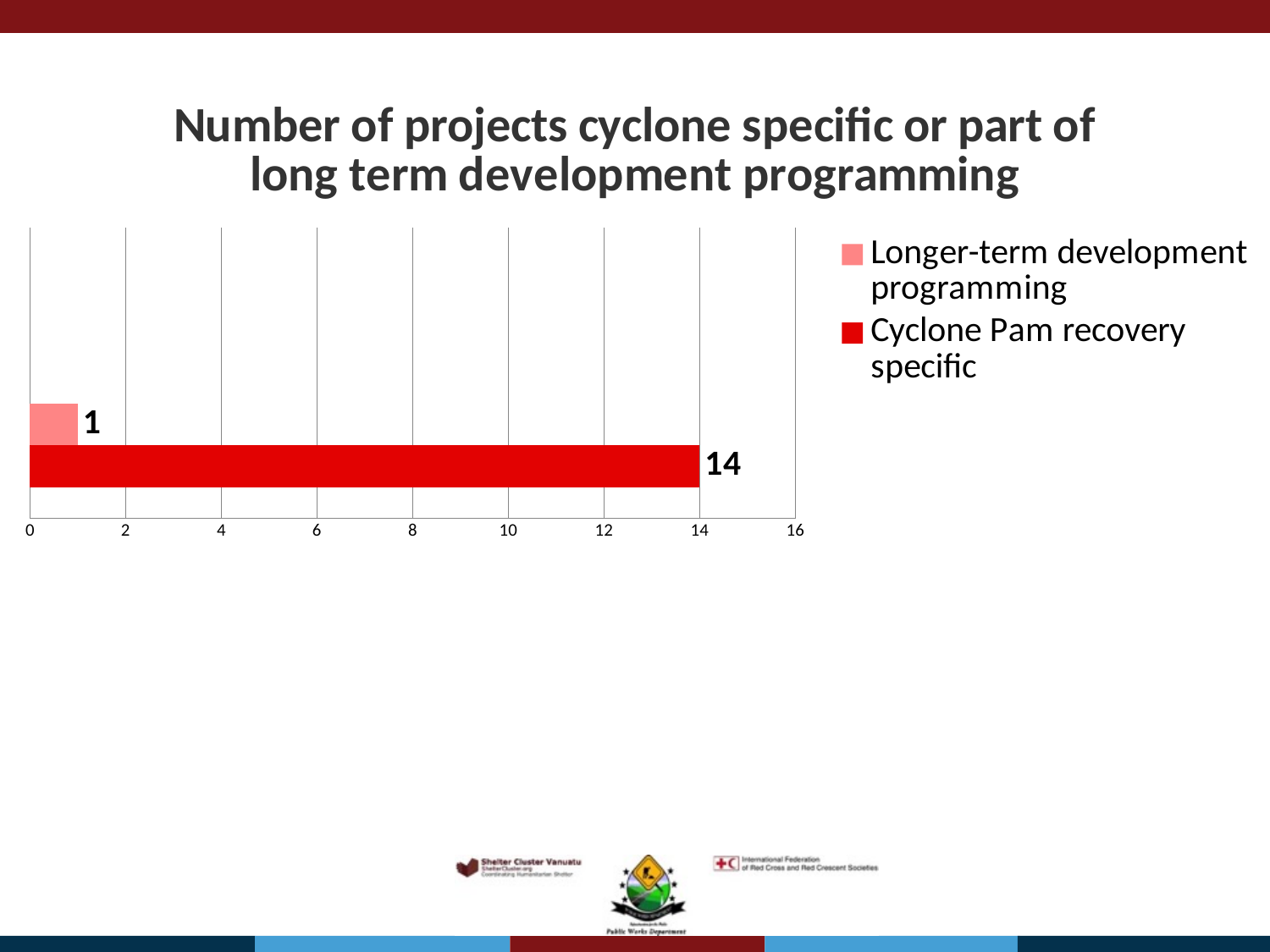
What is the value for Cyclone Pam recovery specific? 14 Which series has the lowest value? Longer-term development programming What is the total of the two values shown in the chart? 15 Is the value for Cyclone Pam recovery specific greater or less than 10? greater What is the title of the chart? Number of projects cyclone specific or part of long term development programming Which series has the highest value? Cyclone Pam recovery specific Which is larger, Cyclone Pam recovery specific or Longer-term development programming? Cyclone Pam recovery specific What kind of chart is shown on the slide? Bar chart What is the difference between the Cyclone Pam recovery specific value and the Longer-term development programming value? 13 What is the value for Longer-term development programming? 1 Is the value for Longer-term development programming greater or less than 2? less How many series does the legend list? 2